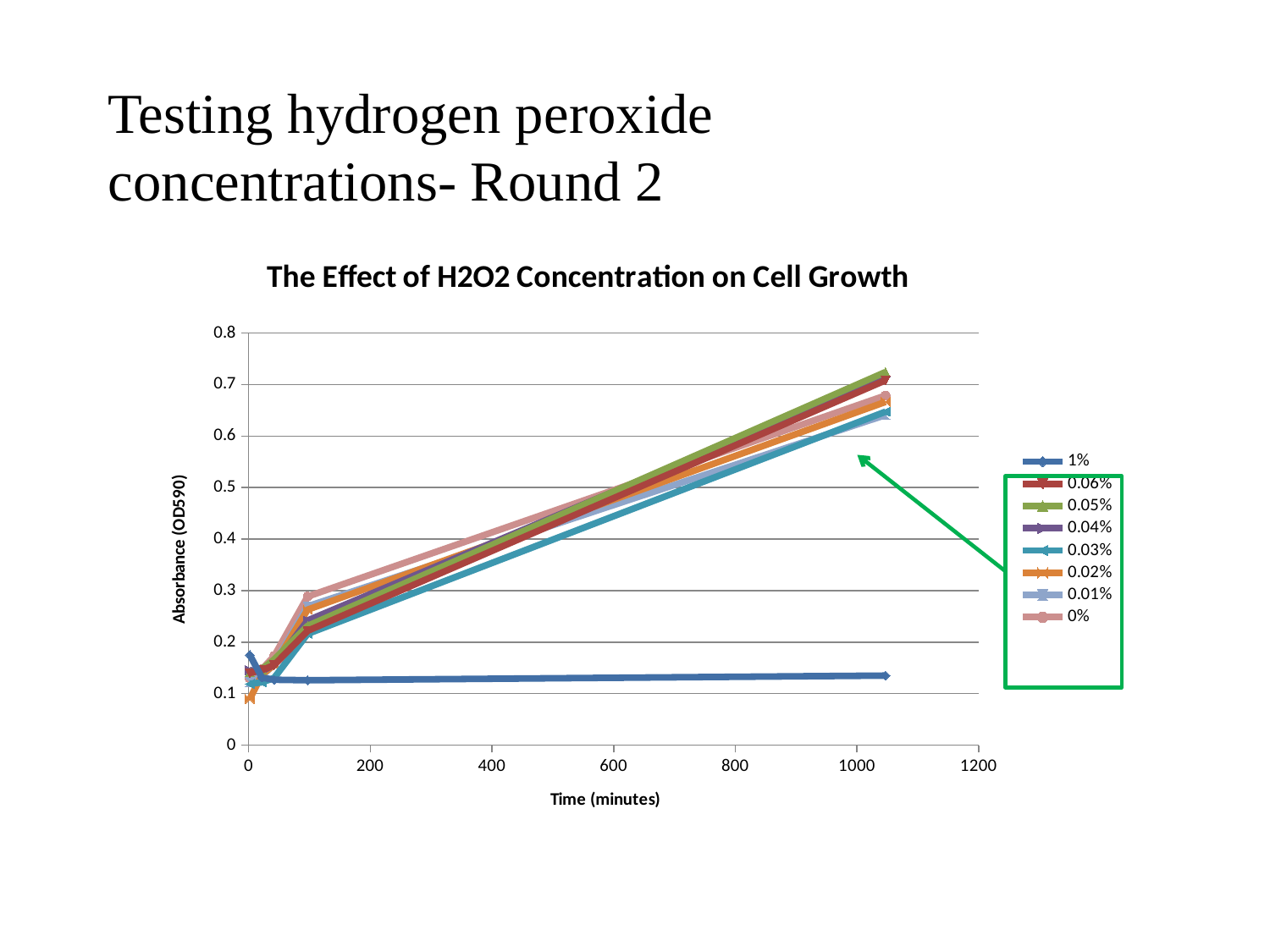
Is the absorbance for the 0.03% series at the final time point greater or less than 0.5? greater Which series has the lowest absorbance at the final time point (around 1050 minutes)? 1% Is the absorbance for the 1% series at the final time point greater or less than 0.2? less What is the label of the y axis? Absorbance (OD590) Does the absorbance for the 0.05% series rise or fall between 100 and 1050 minutes? rise How many series does the legend list? 8 At the final time point, which has the higher absorbance: the 1% series or the 0.05% series? 0.05% What kind of chart is shown on the slide? line chart Is the absorbance for the 0% series at about 100 minutes greater or less than 0.2? greater What is the title of the chart? The Effect of H2O2 Concentration on Cell Growth Does the absorbance for the 1% series rise or fall between 0 and 40 minutes? fall